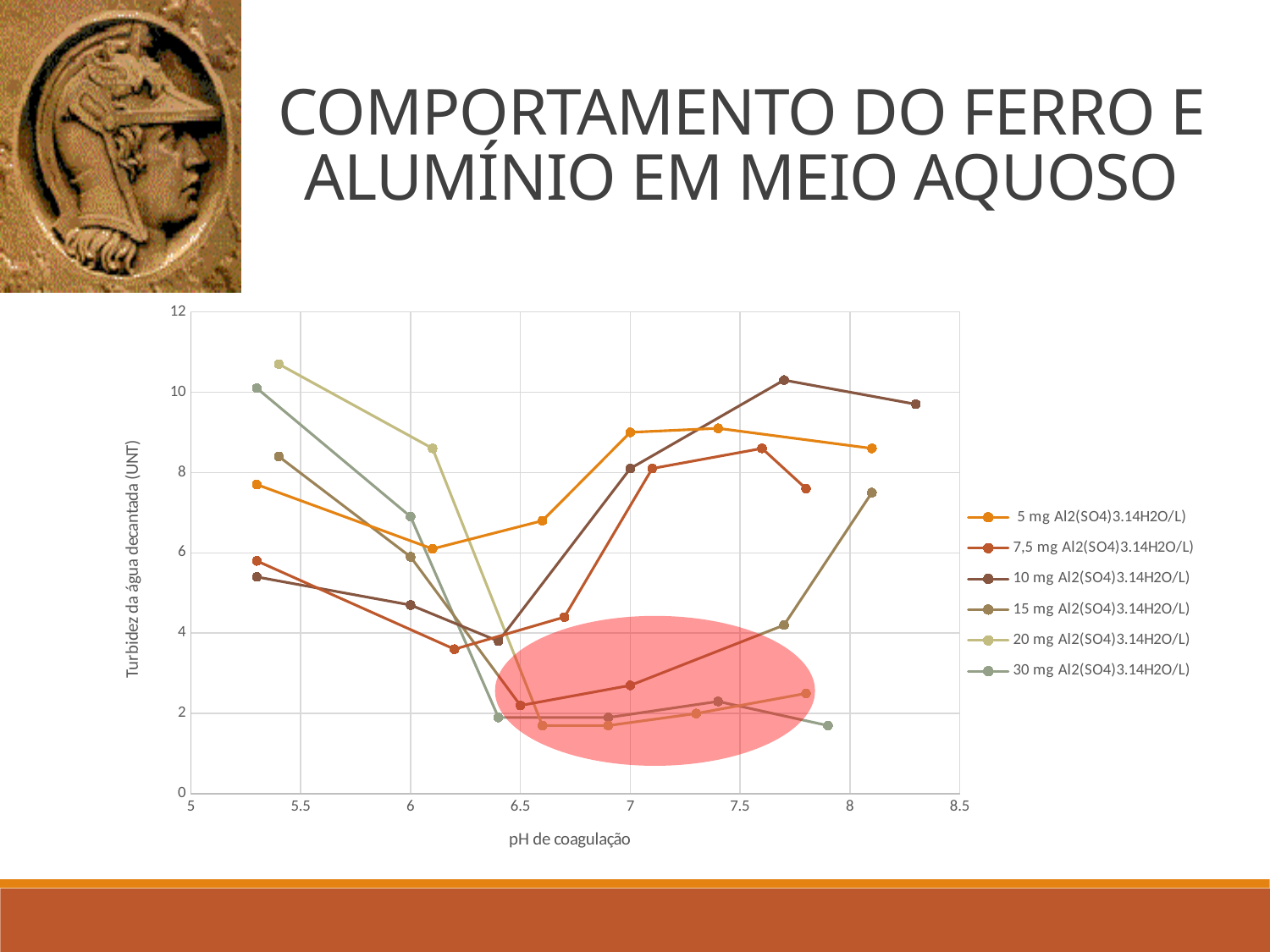
What is the label of the x axis of the chart? pH de coagulação Does the 30 mg Al2(SO4)3.14H2O/L series rise or fall between pH 5.3 and pH 6.4? fall What kind of chart is shown on the slide? Line chart Which series reaches the highest turbidity value on the chart? 20 mg Al2(SO4)3.14H2O/L What is the label of the y axis of the chart? Turbidez da água decantada (UNT) Is the highest value of the 10 mg Al2(SO4)3.14H2O/L series greater or less than 10? greater Does the 5 mg Al2(SO4)3.14H2O/L series rise or fall between pH 6.1 and pH 7? rise Is the first (leftmost) value of the 5 mg Al2(SO4)3.14H2O/L series greater or less than 8? less Is the last (rightmost) value of the 30 mg Al2(SO4)3.14H2O/L series greater or less than 2? less At pH 6.1, which series has the higher turbidity: 20 mg Al2(SO4)3.14H2O/L or 5 mg Al2(SO4)3.14H2O/L? 20 mg Al2(SO4)3.14H2O/L How many series does the chart legend list? 6